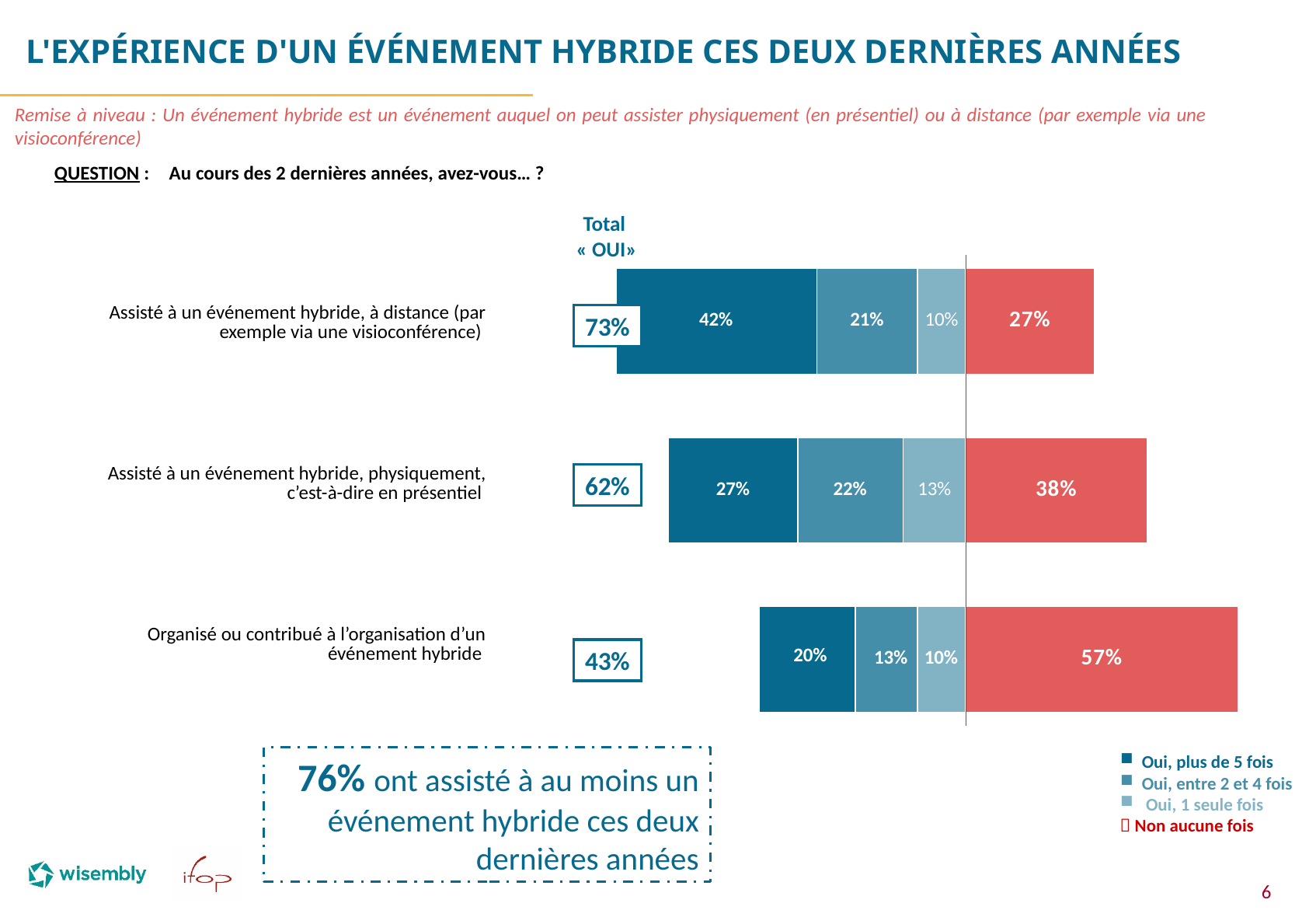
What is the value of "Non aucune fois" for "Organisé ou contribué à l'organisation d'un événement hybride"? 57% What is the "Total OUI" for "Assisté à un événement hybride, physiquement, c'est-à-dire en présentiel"? 62% What is the total of the three "Oui" segments for "Organisé ou contribué à l'organisation d'un événement hybride"? 43% Which is larger: "Oui, 1 seule fois" for "Assisté physiquement" or for "Assisté à distance"? Assisté physiquement Which category has the lowest value for "Oui, plus de 5 fois"? Organisé ou contribué à l'organisation d'un événement hybride How many categories (statements) are plotted in the chart? 3 What is the difference between the "Non aucune fois" values for "Organisé ou contribué" and "Assisté à distance"? 30 percentage points What is the value of "Oui, entre 2 et 4 fois" for "Assisté à un événement hybride, physiquement"? 22% How many series does the legend list? 4 Which category has the highest "Total OUI"? Assisté à un événement hybride, à distance What kind of chart is shown on the slide? Stacked bar chart What is the value of "Oui, plus de 5 fois" for "Assisté à un événement hybride, à distance"? 42%